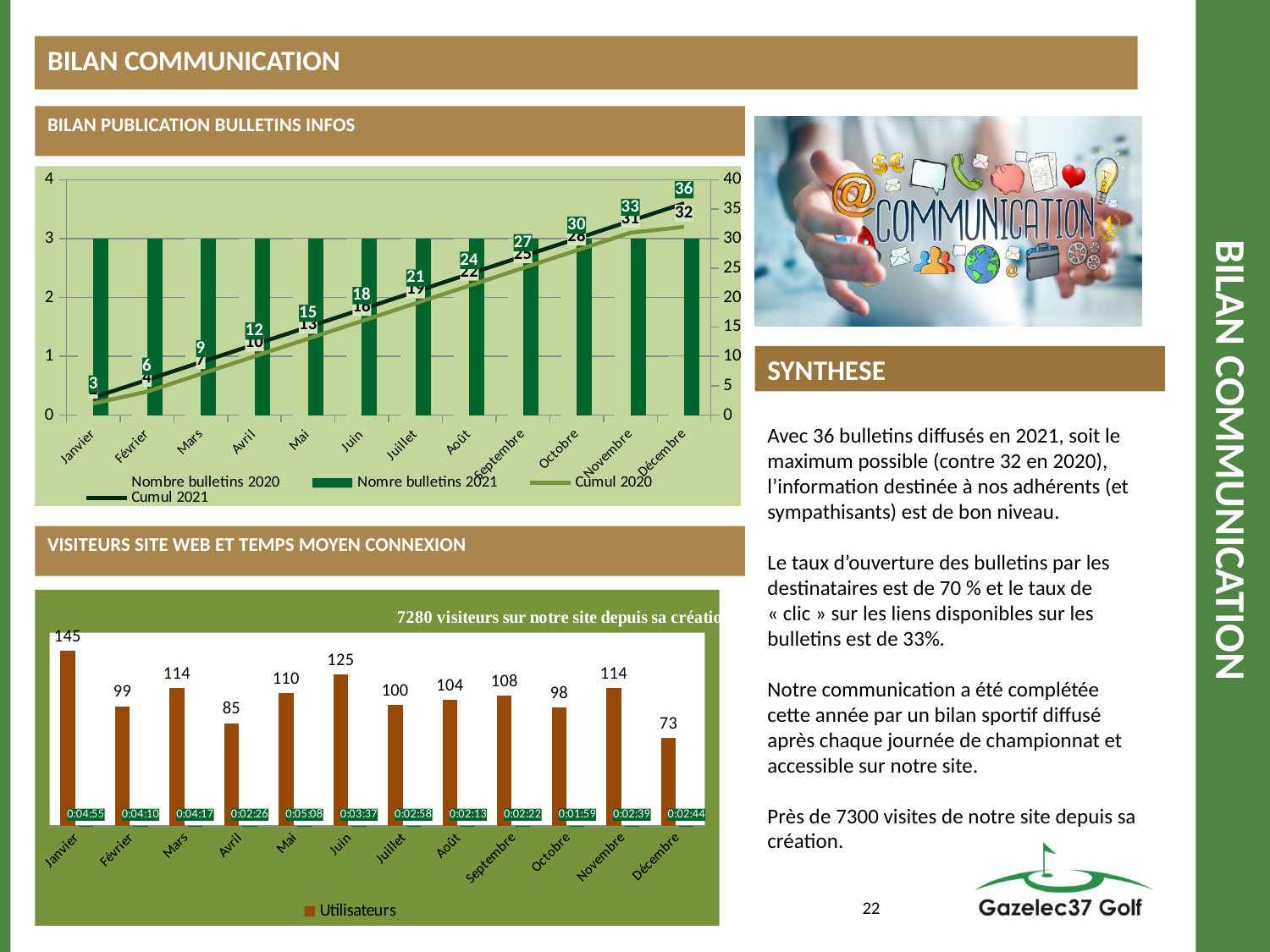
In the 'BILAN PUBLICATION BULLETINS INFOS' chart, what is the Cumul 2021 value for Décembre? 36 In the 'VISITEURS SITE WEB ET TEMPS MOYEN CONNEXION' chart, what is the time label shown for Mai? 0:05:08 How many months are shown on the x axis of the 'VISITEURS SITE WEB ET TEMPS MOYEN CONNEXION' chart? 12 What type of chart is the 'VISITEURS SITE WEB ET TEMPS MOYEN CONNEXION' chart? Bar chart In the 'VISITEURS SITE WEB ET TEMPS MOYEN CONNEXION' chart, which month has the lowest number of Utilisateurs? Décembre In the 'VISITEURS SITE WEB ET TEMPS MOYEN CONNEXION' chart, which month has the highest number of Utilisateurs? Janvier In the 'VISITEURS SITE WEB ET TEMPS MOYEN CONNEXION' chart, which is larger, the value for Mai or the value for Octobre? Mai In the 'VISITEURS SITE WEB ET TEMPS MOYEN CONNEXION' chart, what is the difference between the values for Juin and Avril? 40 In the 'BILAN PUBLICATION BULLETINS INFOS' chart, does the Cumul 2021 line rise or fall from Janvier to Décembre? Rise How many series does the legend of the 'BILAN PUBLICATION BULLETINS INFOS' chart list? 4 In the 'VISITEURS SITE WEB ET TEMPS MOYEN CONNEXION' chart, what is the value for Janvier? 145 In the 'BILAN PUBLICATION BULLETINS INFOS' chart, what is the Cumul 2020 value for Décembre? 32